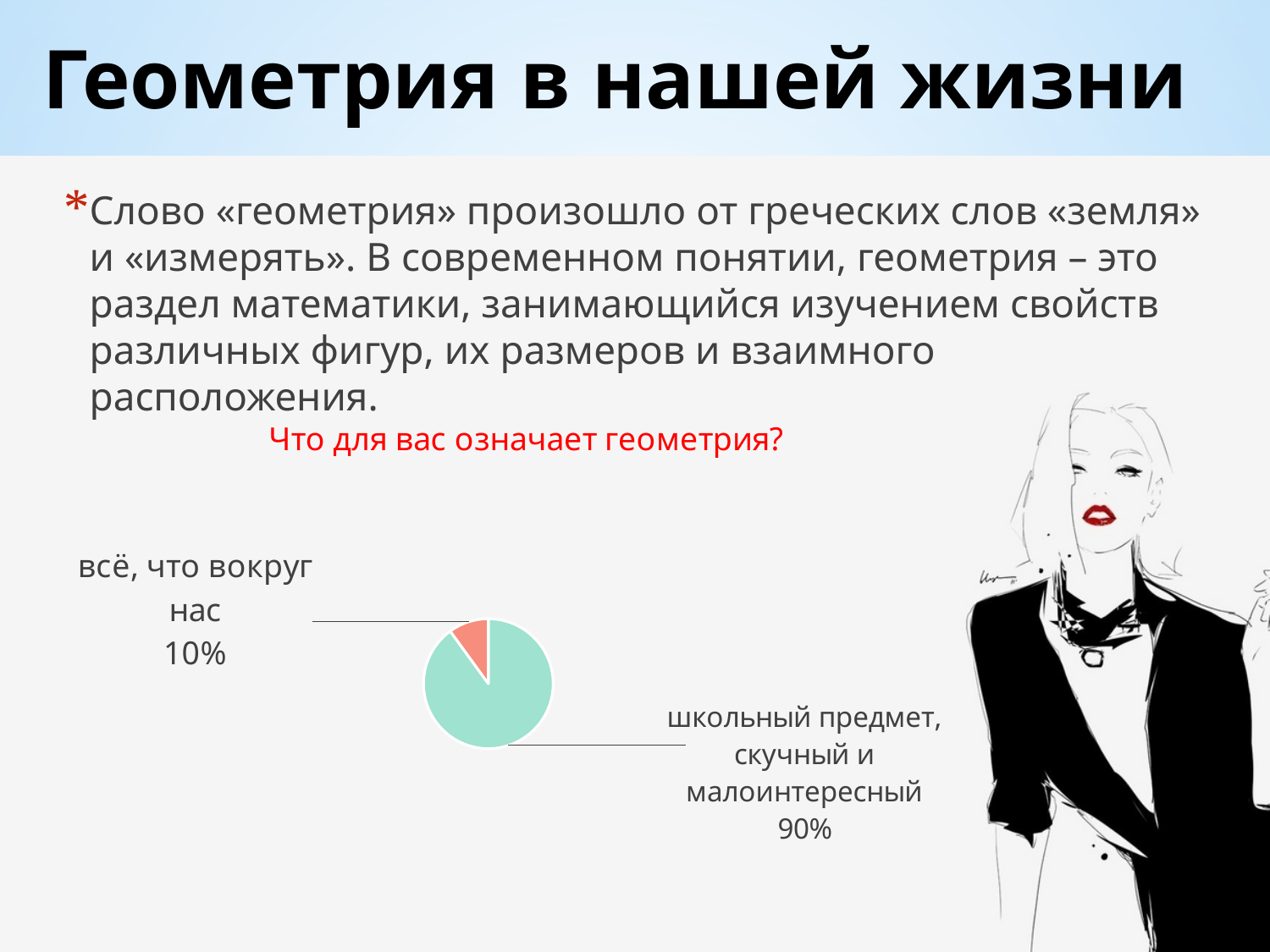
What is the difference in percentage points between the "школьный предмет, скучный и малоинтересный" slice and the "всё, что вокруг нас" slice? 80 percentage points Which slice of the pie is the largest? школьный предмет, скучный и малоинтересный What colour is the "всё, что вокруг нас" slice of the pie? pink/salmon What share of the pie does "школьный предмет, скучный и малоинтересный" have? 90% What question is posed in red text above the pie chart? Что для вас означает геометрия? How many slices does the pie chart have? 2 Which slice of the pie is the smallest? всё, что вокруг нас Which is larger: the "всё, что вокруг нас" slice or the "школьный предмет, скучный и малоинтересный" slice? школьный предмет, скучный и малоинтересный What share of the pie does "всё, что вокруг нас" have? 10% What kind of chart is shown on the slide? pie chart